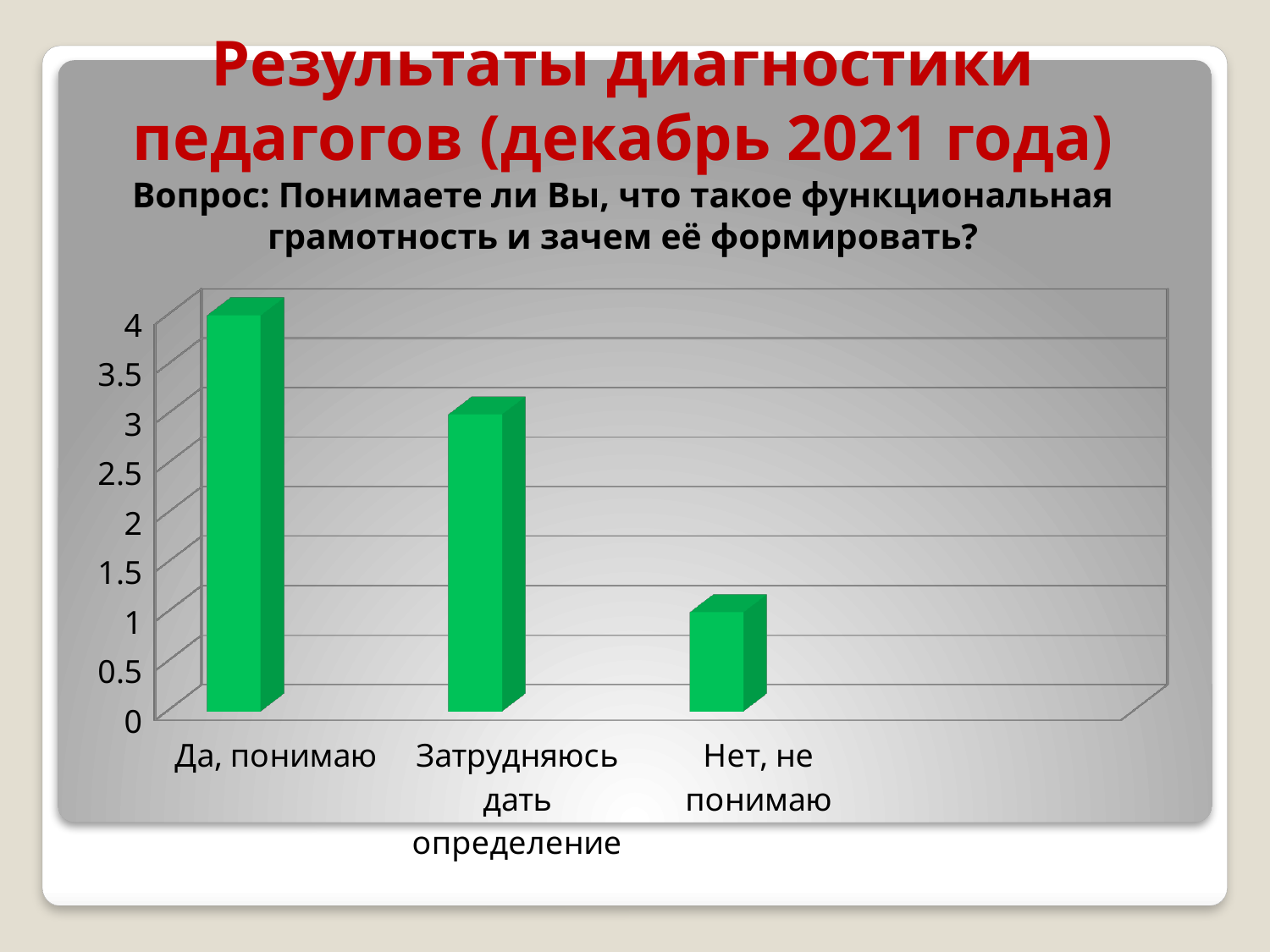
Which category has the highest value? Да, понимаю Is the value for "Затрудняюсь дать определение" greater or less than 2? greater What is the value for "Да, понимаю"? 4 How many categories are shown on the x axis of the chart? 3 Do the values rise or fall from left to right along the x axis? fall What is the difference between the values for "Да, понимаю" and "Нет, не понимаю"? 3 Which category has the lowest value? Нет, не понимаю Which is larger: the value for "Да, понимаю" or the value for "Нет, не понимаю"? Да, понимаю What is the value for "Затрудняюсь дать определение"? 3 What question is the chart on the slide about? Понимаете ли Вы, что такое функциональная грамотность и зачем её формировать? What kind of chart is shown on the slide? bar chart What is the value for "Нет, не понимаю"? 1